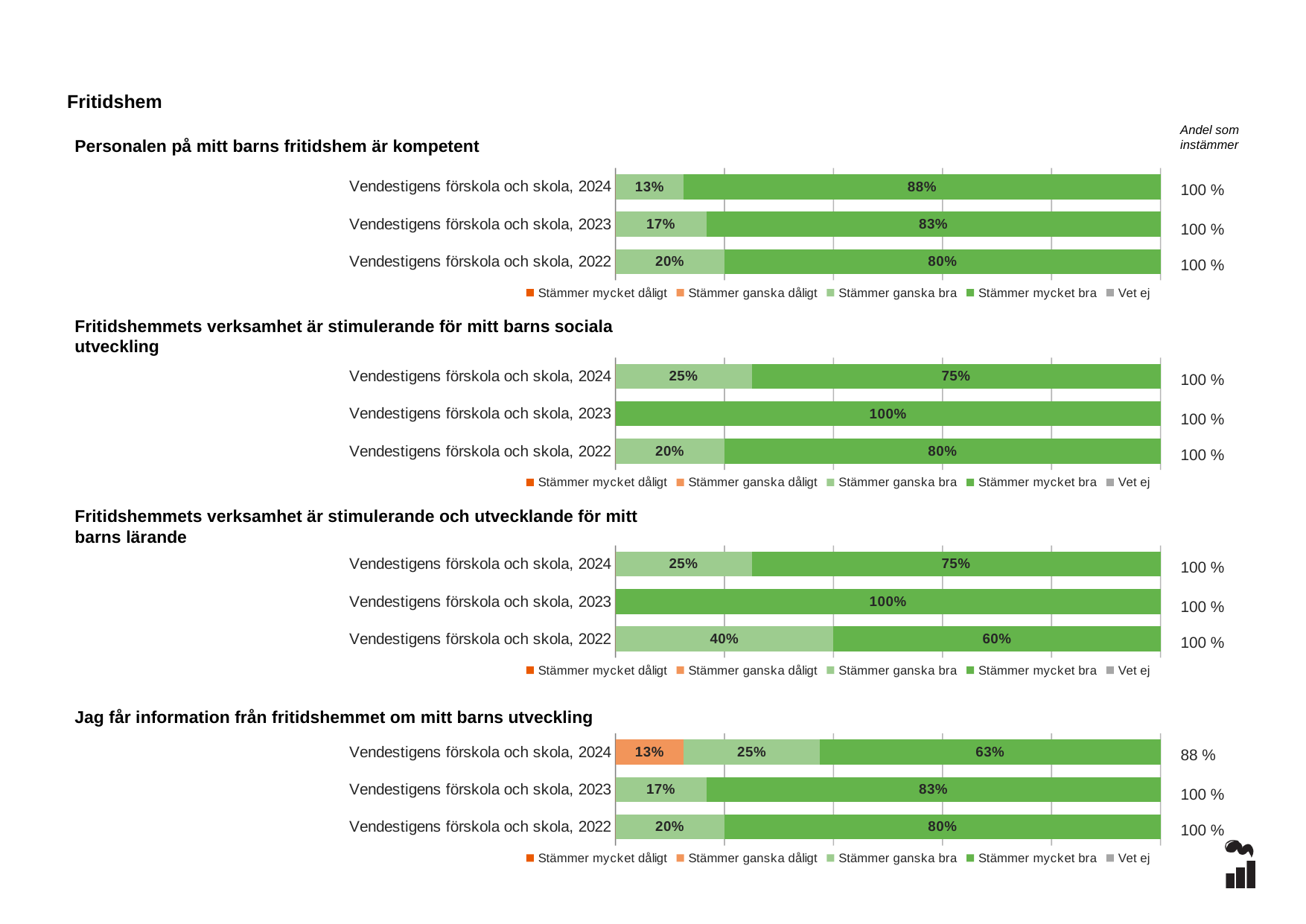
In the chart 'Jag får information från fritidshemmet om mitt barns utveckling', what is the value for 'Stämmer ganska dåligt' for Vendestigens förskola och skola, 2024? 13% In the chart 'Personalen på mitt barns fritidshem är kompetent', what is the value for 'Stämmer mycket bra' for Vendestigens förskola och skola, 2024? 88% How many series does the legend list for the chart 'Personalen på mitt barns fritidshem är kompetent'? 5 In the chart 'Personalen på mitt barns fritidshem är kompetent', which year has the highest value for 'Stämmer mycket bra'? 2024 In the chart 'Fritidshemmets verksamhet är stimulerande och utvecklande för mitt barns lärande', which year has the lowest value for 'Stämmer mycket bra'? 2022 In the chart 'Fritidshemmets verksamhet är stimulerande för mitt barns sociala utveckling', what is the value for 'Stämmer mycket bra' for Vendestigens förskola och skola, 2023? 100% What kind of chart is 'Jag får information från fritidshemmet om mitt barns utveckling'? Stacked bar chart In the chart 'Jag får information från fritidshemmet om mitt barns utveckling', is the 'Stämmer mycket bra' value larger for 2023 or 2024? 2023 In the chart 'Fritidshemmets verksamhet är stimulerande för mitt barns sociala utveckling', what is the difference between the 'Stämmer mycket bra' values for 2022 and 2024? 5% In the chart 'Personalen på mitt barns fritidshem är kompetent', what is the value for 'Stämmer ganska bra' for Vendestigens förskola och skola, 2022? 20% In the chart 'Fritidshemmets verksamhet är stimulerande och utvecklande för mitt barns lärande', what is the value for 'Stämmer ganska bra' for Vendestigens förskola och skola, 2022? 40% In the chart 'Jag får information från fritidshemmet om mitt barns utveckling', what is the 'Andel som instämmer' for Vendestigens förskola och skola, 2024? 88 %